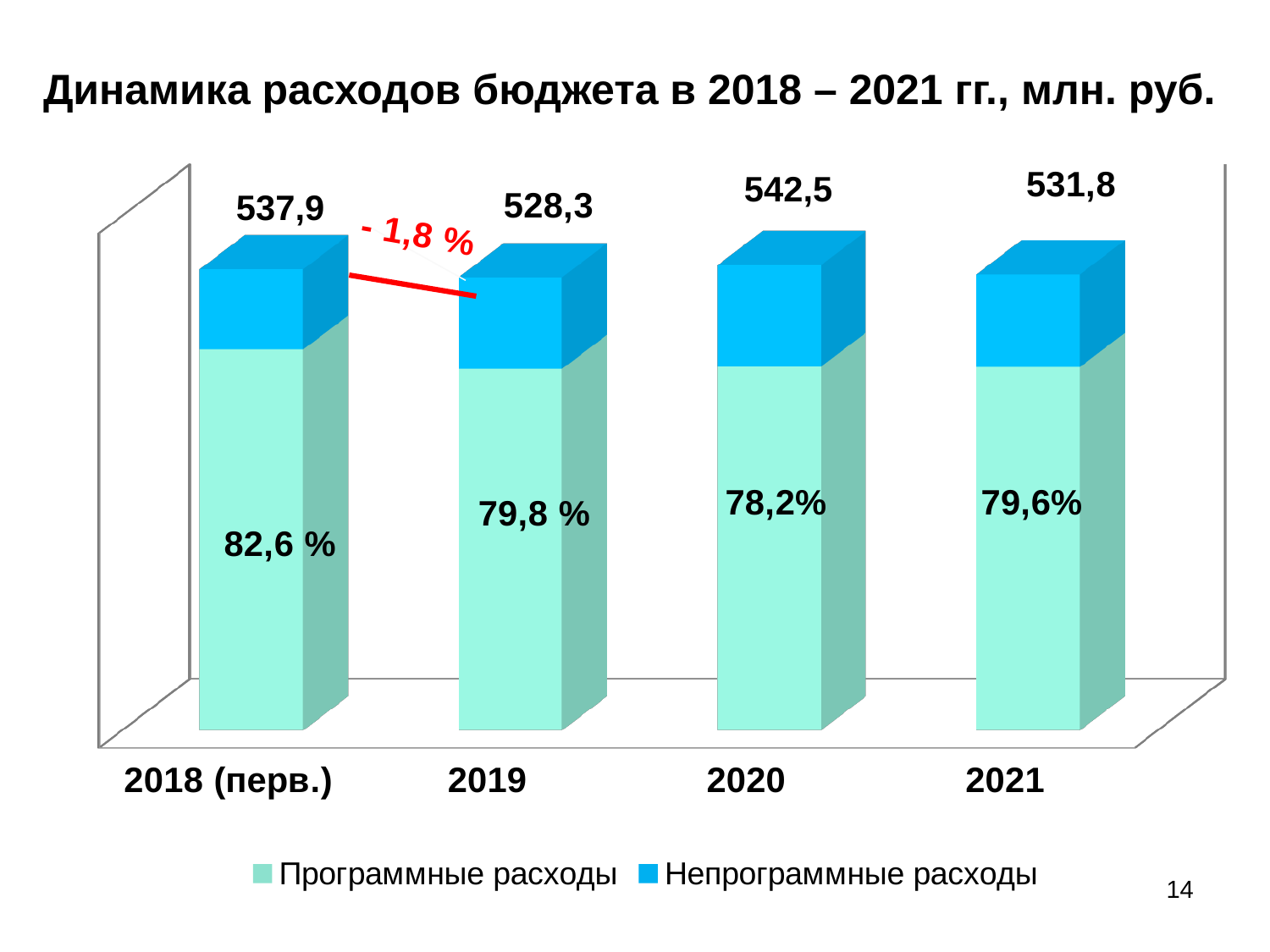
Which year has the lowest total budget expenditure? 2019 What percentage change is annotated in red between 2018 (перв.) and 2019? - 1,8 % What is the total budget expenditure shown for 2020? 542,5 What is the difference between the total expenditure in 2018 (перв.) and in 2019? 9,6 What share of expenditures is labelled as Программные расходы in 2019? 79,8 % How many series does the legend list? 2 Which year has the highest total budget expenditure? 2020 Which year has the lowest share of Программные расходы? 2020 Which is larger, the total expenditure in 2020 or in 2021? 2020 What share of expenditures is labelled as Программные расходы in 2021? 79,6% How many years are shown on the x axis? 4 What is the total budget expenditure shown for 2018 (перв.)? 537,9